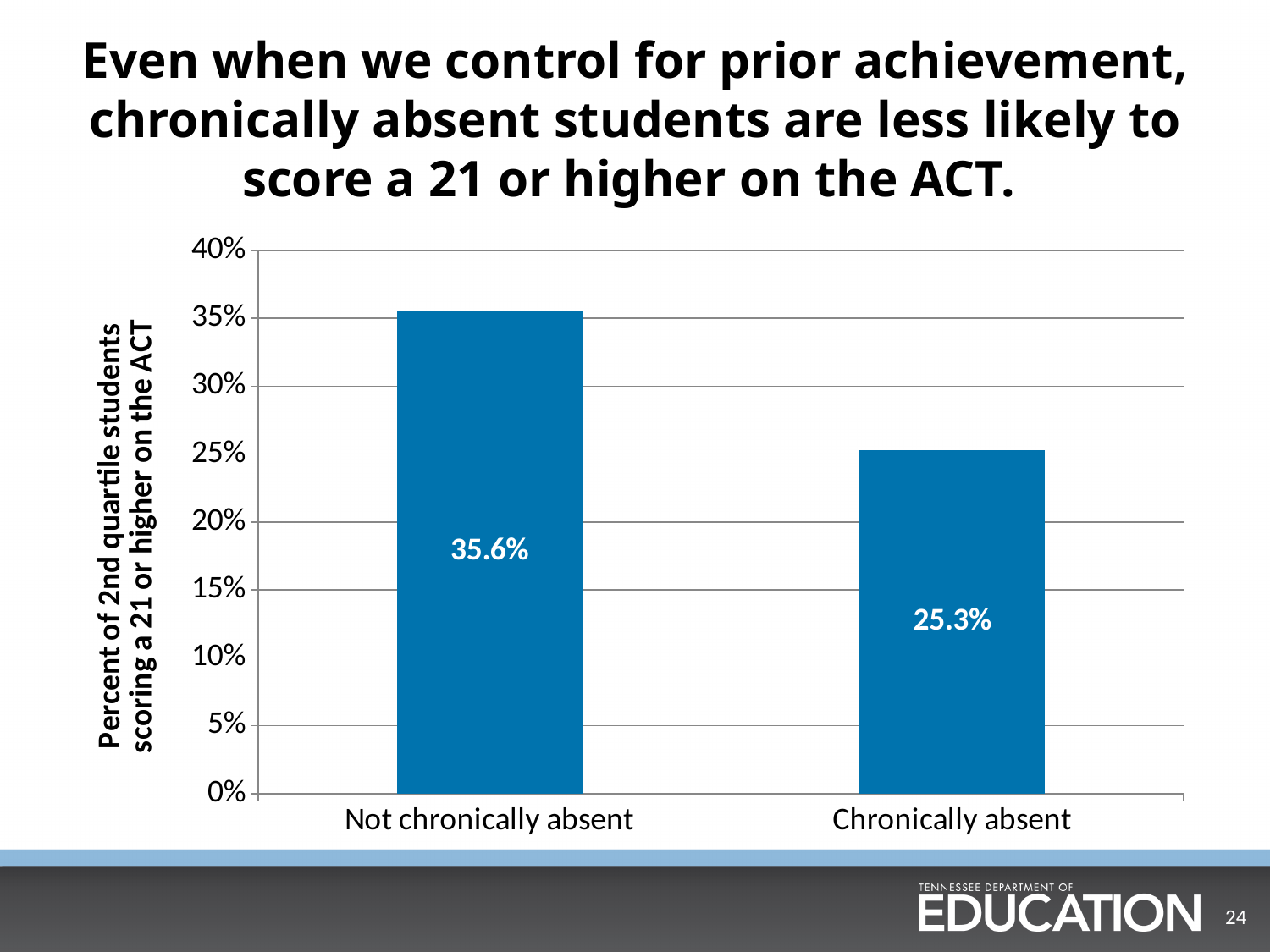
What is the value for Not chronically absent? 35.6% Is the value for Chronically absent greater or less than 30%? less Which category has the lowest value? Chronically absent What is the difference between the values for Not chronically absent and Chronically absent? 10.3% Which category has the highest value? Not chronically absent What kind of chart is shown on the slide? bar chart What is the label of the vertical axis? Percent of 2nd quartile students scoring a 21 or higher on the ACT What is the value for Chronically absent? 25.3% Which is larger, the value for Not chronically absent or the value for Chronically absent? Not chronically absent What is the highest value shown on the vertical axis? 40% Is the value for Not chronically absent greater or less than 35%? greater How many categories are shown on the x axis? 2